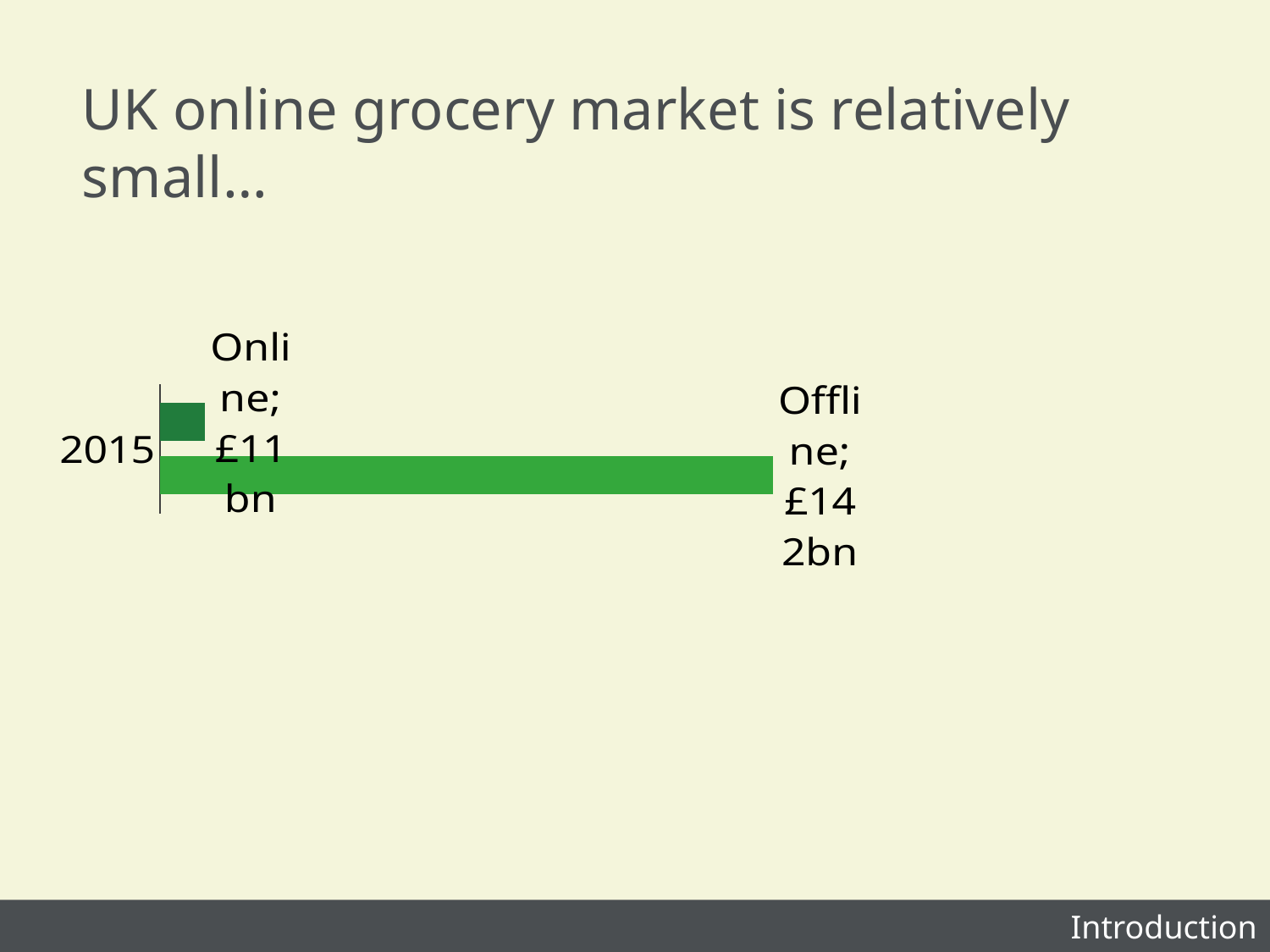
What is the value for Online in 2015? £11bn What is the difference between the Offline and Online values in 2015? £131bn What kind of chart is shown on the slide? Bar chart Which series has the smallest value in 2015? Online What is the title of the slide containing the chart? UK online grocery market is relatively small... Which year is shown on the chart's category axis? 2015 Which series has the largest value in 2015? Offline How many categories are shown on the chart's category axis? 1 Which series has the larger value in 2015, Online or Offline? Offline How many series are plotted on the chart? 2 What is the value for Offline in 2015? £142bn